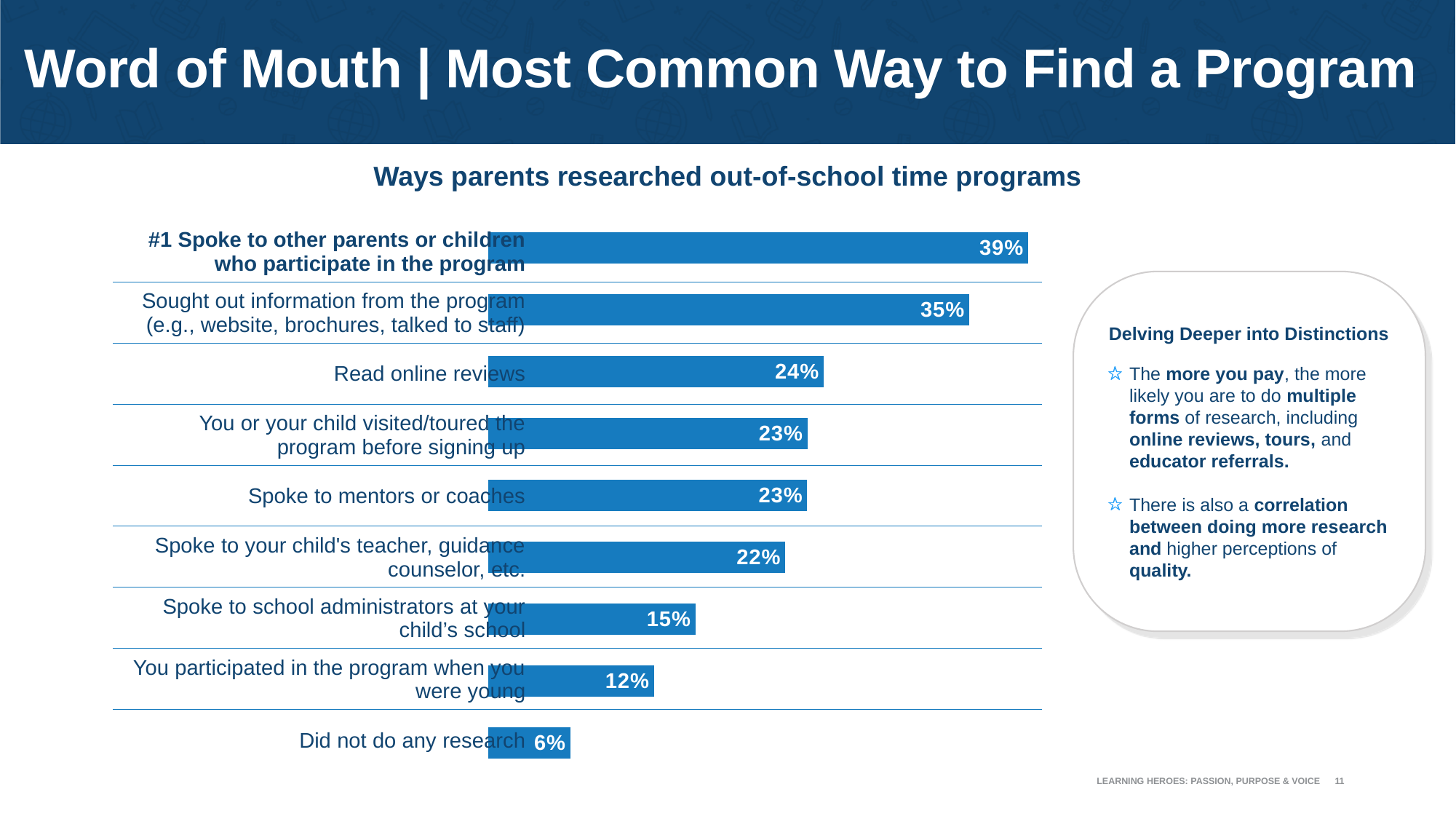
Which category has the lowest percentage? Did not do any research What is the difference in percentage points between 'Spoke to other parents or children who participate in the program' and 'Sought out information from the program'? 4 percentage points What kind of chart is shown on the slide? Bar chart What percentage of parents spoke to school administrators at their child's school? 15% What is the difference in percentage points between 'You participated in the program when you were young' and 'Did not do any research'? 6 percentage points Which is larger: the percentage who read online reviews or the percentage who spoke to mentors or coaches? Read online reviews What is the title of the chart? Ways parents researched out-of-school time programs What percentage of parents spoke to other parents or children who participate in the program? 39% How many categories are shown in the chart? 9 What percentage of parents read online reviews? 24% Which way of researching programs has the highest percentage? Spoke to other parents or children who participate in the program What percentage of parents did not do any research? 6%